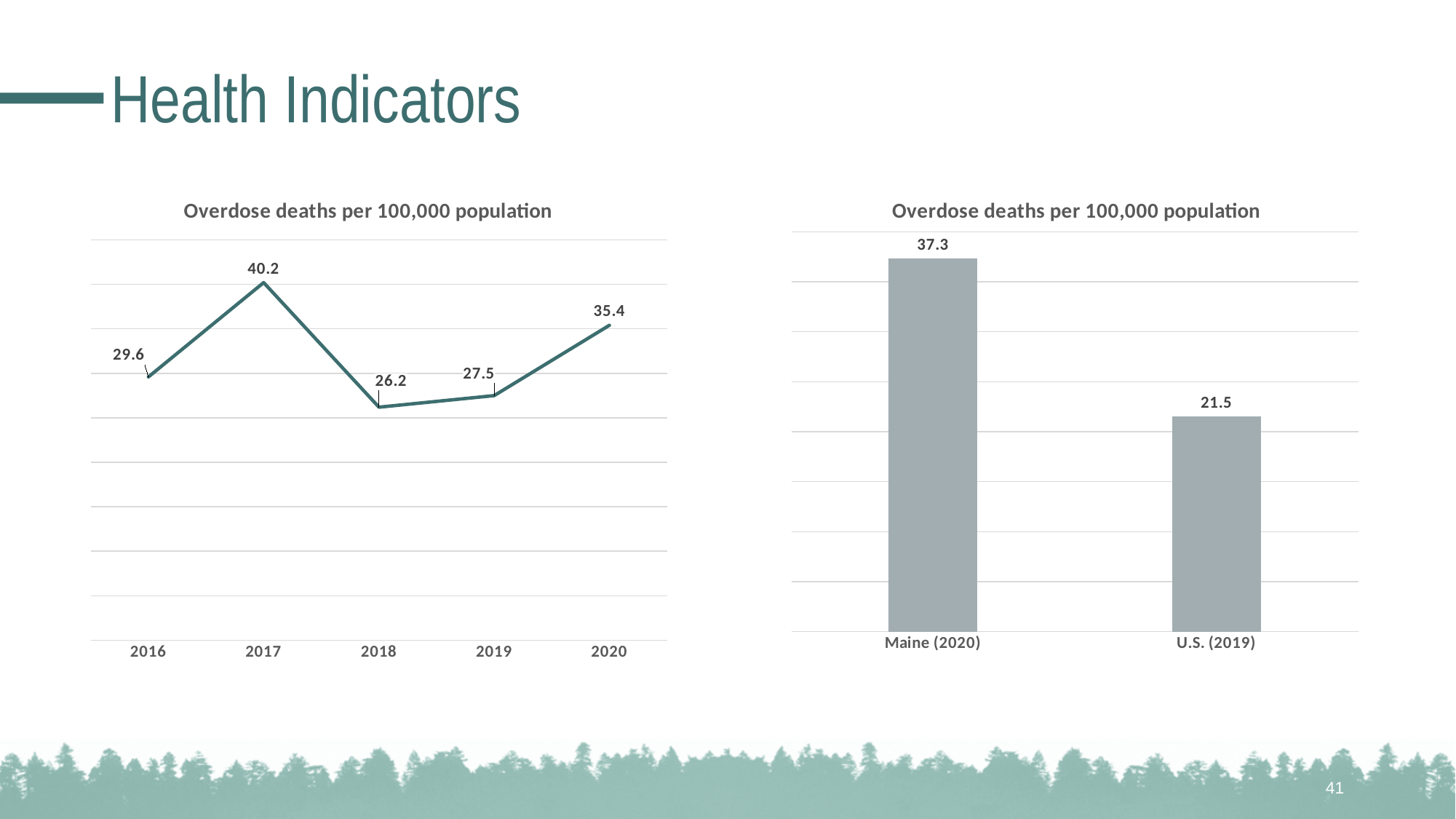
In the line chart on the left, which year has the highest value? 2017 In the line chart on the left, what is the value for 2020? 35.4 In the line chart on the left, what is the value for 2017? 40.2 What kind of chart is on the right side of the slide? bar chart In the line chart on the left, which year has the lowest value? 2018 In the bar chart on the right, what is the value for U.S. (2019)? 21.5 What is the title of the chart on the left? Overdose deaths per 100,000 population In the line chart on the left, what is the difference between the 2017 and 2018 values? 14 In the line chart on the left, how many years are plotted? 5 In the line chart on the left, does the value rise or fall from 2018 to 2020? rise In the bar chart on the right, what is the difference between Maine (2020) and U.S. (2019)? 15.8 In the bar chart on the right, what is the value for Maine (2020)? 37.3